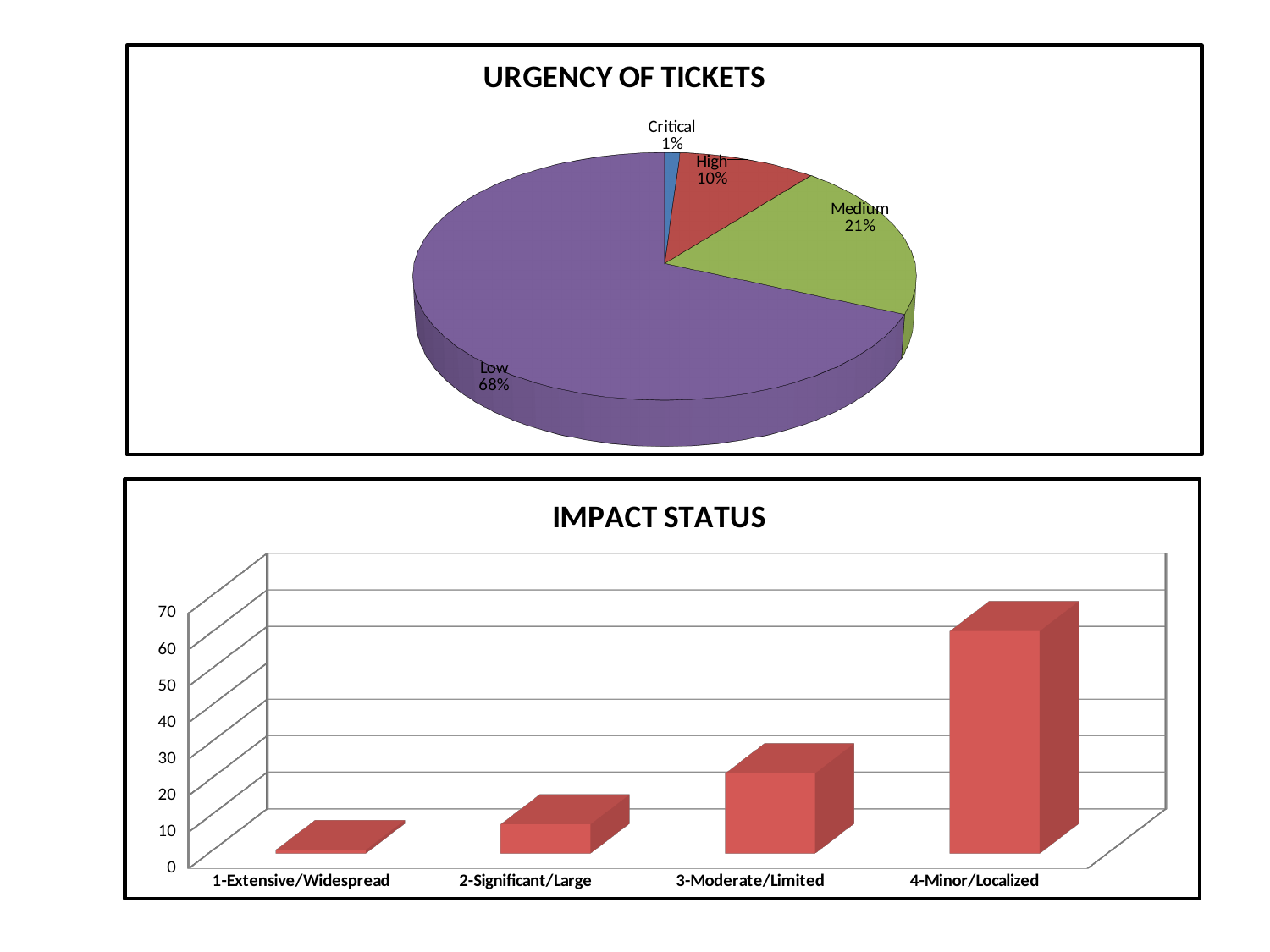
In the URGENCY OF TICKETS chart, which urgency level has the smallest share? Critical In the IMPACT STATUS chart, is the value for 4-Minor/Localized greater or less than 50? greater In the URGENCY OF TICKETS chart, what share of tickets is Low urgency? 68% In the URGENCY OF TICKETS chart, which urgency level has the largest share? Low In the URGENCY OF TICKETS chart, what percentage of tickets is Critical? 1% What kind of chart is the URGENCY OF TICKETS chart? Pie chart In the IMPACT STATUS chart, do the values rise or fall from left to right along the x axis? Rise In the URGENCY OF TICKETS chart, what is the difference in percentage points between Medium and High? 11 What kind of chart is the IMPACT STATUS chart? Bar chart In the URGENCY OF TICKETS chart, how many slices does the pie have? 4 In the URGENCY OF TICKETS chart, what percentage of tickets is Medium urgency? 21% In the IMPACT STATUS chart, which category has the highest value? 4-Minor/Localized